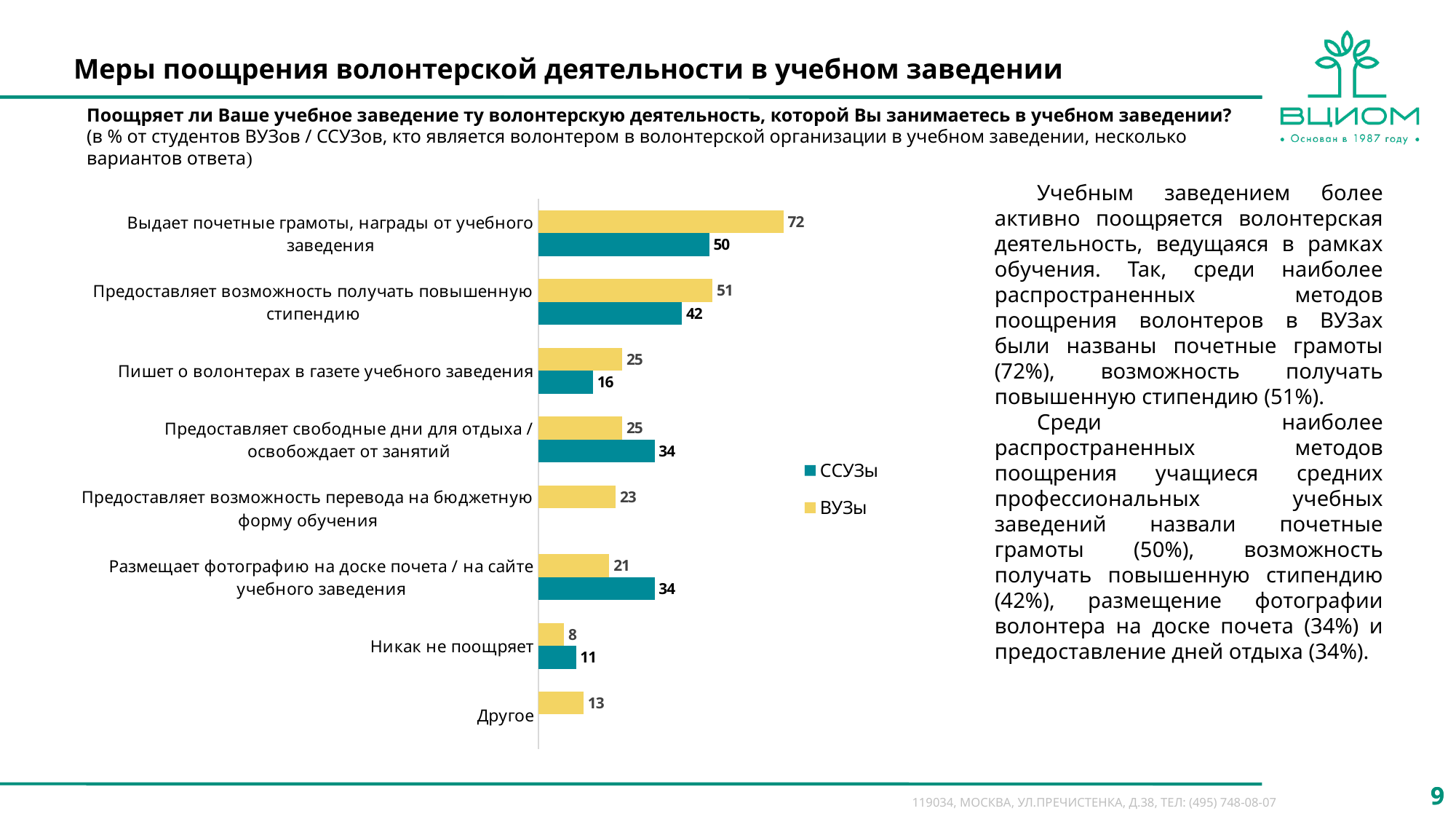
What colour are the bars for the ВУЗы series? Yellow Which category has the highest value for ВУЗы? Выдает почетные грамоты, награды от учебного заведения What type of chart is shown on the slide? Bar chart What is the value for ССУЗы in the category "Никак не поощряет"? 11 How many series does the legend list? 2 For "Пишет о волонтерах в газете учебного заведения", which series has the larger value, ССУЗы or ВУЗы? ВУЗы Which category has the lowest value for ВУЗы? Никак не поощряет For "Размещает фотографию на доске почета / на сайте учебного заведения", which series has the larger value, ССУЗы or ВУЗы? ССУЗы What is the value for ССУЗы in the category "Предоставляет возможность получать повышенную стипендию"? 42 What is the difference between the ВУЗы and ССУЗы values for "Выдает почетные грамоты, награды от учебного заведения"? 22 How many categories are shown on the chart? 8 What is the value for ВУЗы in the category "Выдает почетные грамоты, награды от учебного заведения"? 72